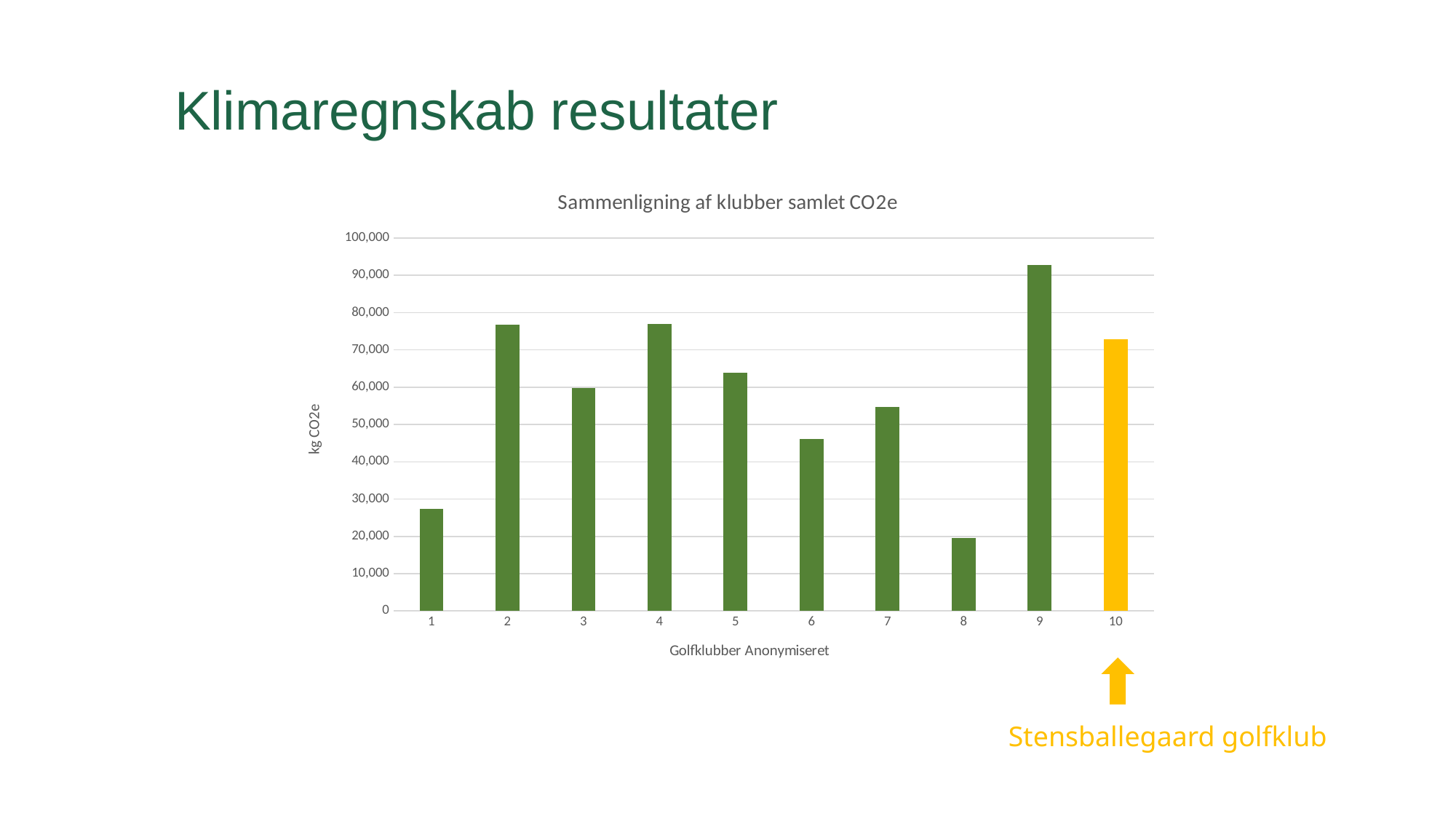
Which has a higher total CO2e, club 6 or club 7? 7 What is the title of the chart? Sammenligning af klubber samlet CO2e Which golf club has the lowest total CO2e? 8 What kind of chart is shown on the slide? bar chart Is the value for club 6 greater or less than 50,000? less Is the value for club 9 greater or less than 90,000? greater How many golf clubs are plotted on the x axis? 10 Is the value for club 1 greater or less than 30,000? less Which golf club has the highest total CO2e? 9 Which has a higher total CO2e, club 9 or club 10? 9 Which club's bar is highlighted in yellow and labelled Stensballegaard golfklub? 10